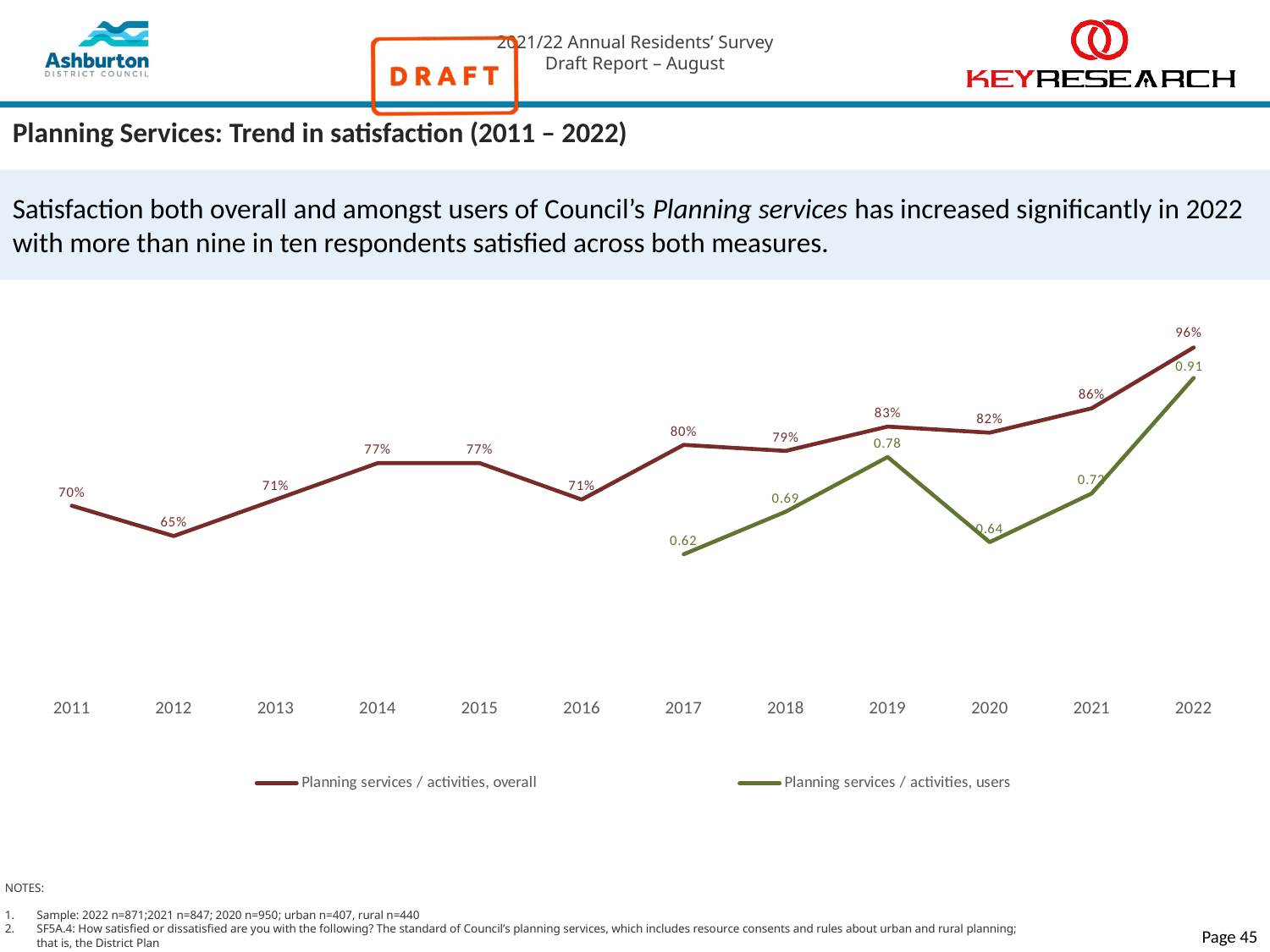
How many series does the legend list? 2 What is the first year for which a value is plotted for Planning services / activities, users? 2017 What kind of chart is shown on the slide? Line chart In which year is Planning services / activities, overall lowest? 2012 Does Planning services / activities, overall rise or fall from 2019 to 2022? Rise In which year is Planning services / activities, users highest? 2022 What is the value for Planning services / activities, overall in 2022? 96% What is the value for Planning services / activities, overall in 2012? 65% What is the difference between the overall satisfaction values for 2022 and 2021? 10% Which is larger for Planning services / activities, overall: 2017 or 2018? 2017 What is the value for Planning services / activities, users in 2019? 0.78 How many years are shown on the x axis? 12